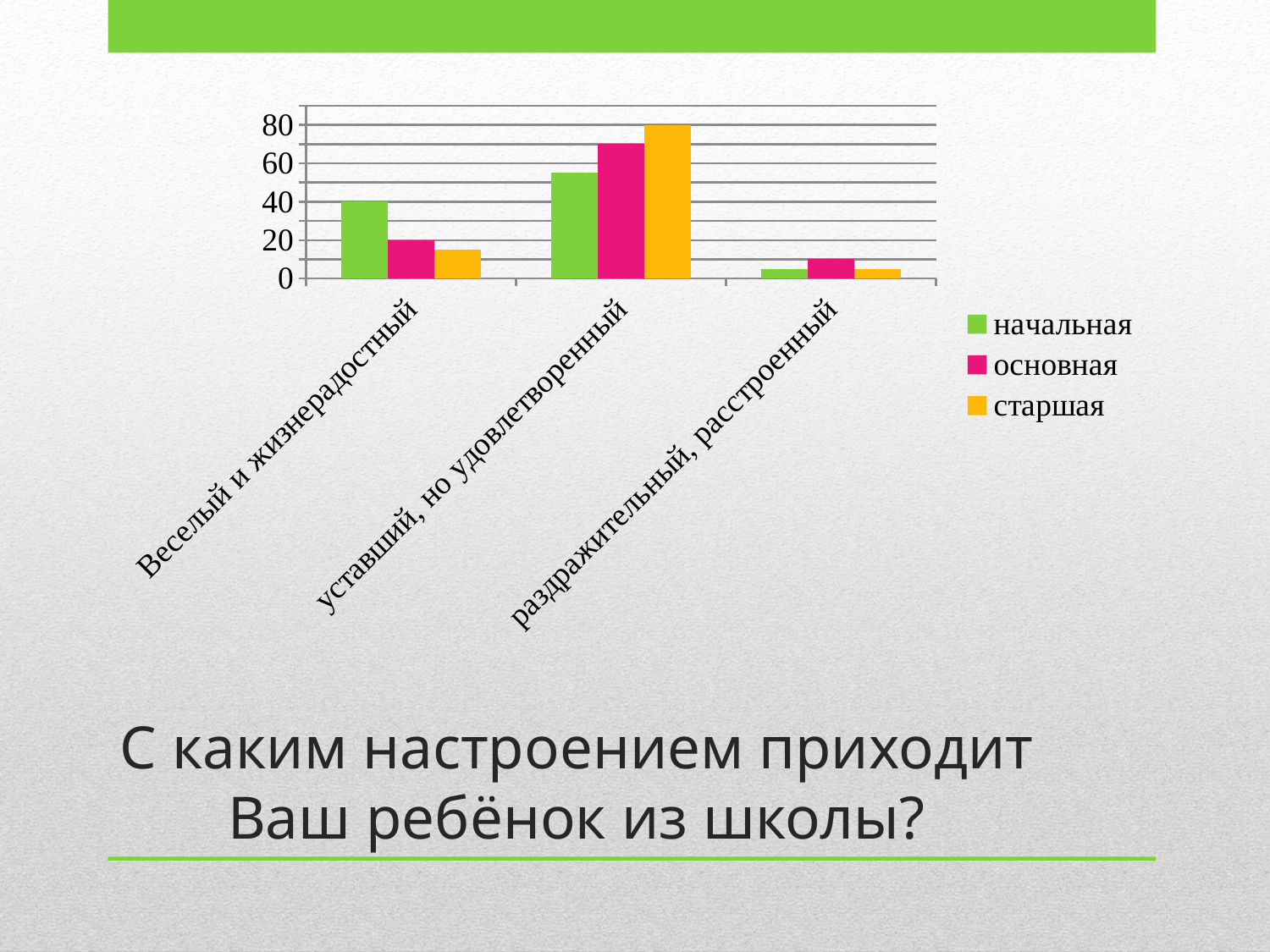
What is the value for основная in the category Веселый и жизнерадостный? 20 In the category Веселый и жизнерадостный, what is the difference between начальная and основная? 20 For the series старшая, which category has the highest value? уставший, но удовлетворенный What is the value for начальная in the category Веселый и жизнерадостный? 40 Is the value for старшая in the category Веселый и жизнерадостный greater or less than 20? less For the series основная, which category has the lowest value? раздражительный, расстроенный How many categories are shown on the x axis? 3 In the category уставший, но удовлетворенный, which is larger: начальная or основная? основная How many series does the legend list? 3 What kind of chart is shown on the slide? bar chart Is the value for начальная in the category уставший, но удовлетворенный greater or less than 40? greater What is the value for старшая in the category уставший, но удовлетворенный? 80